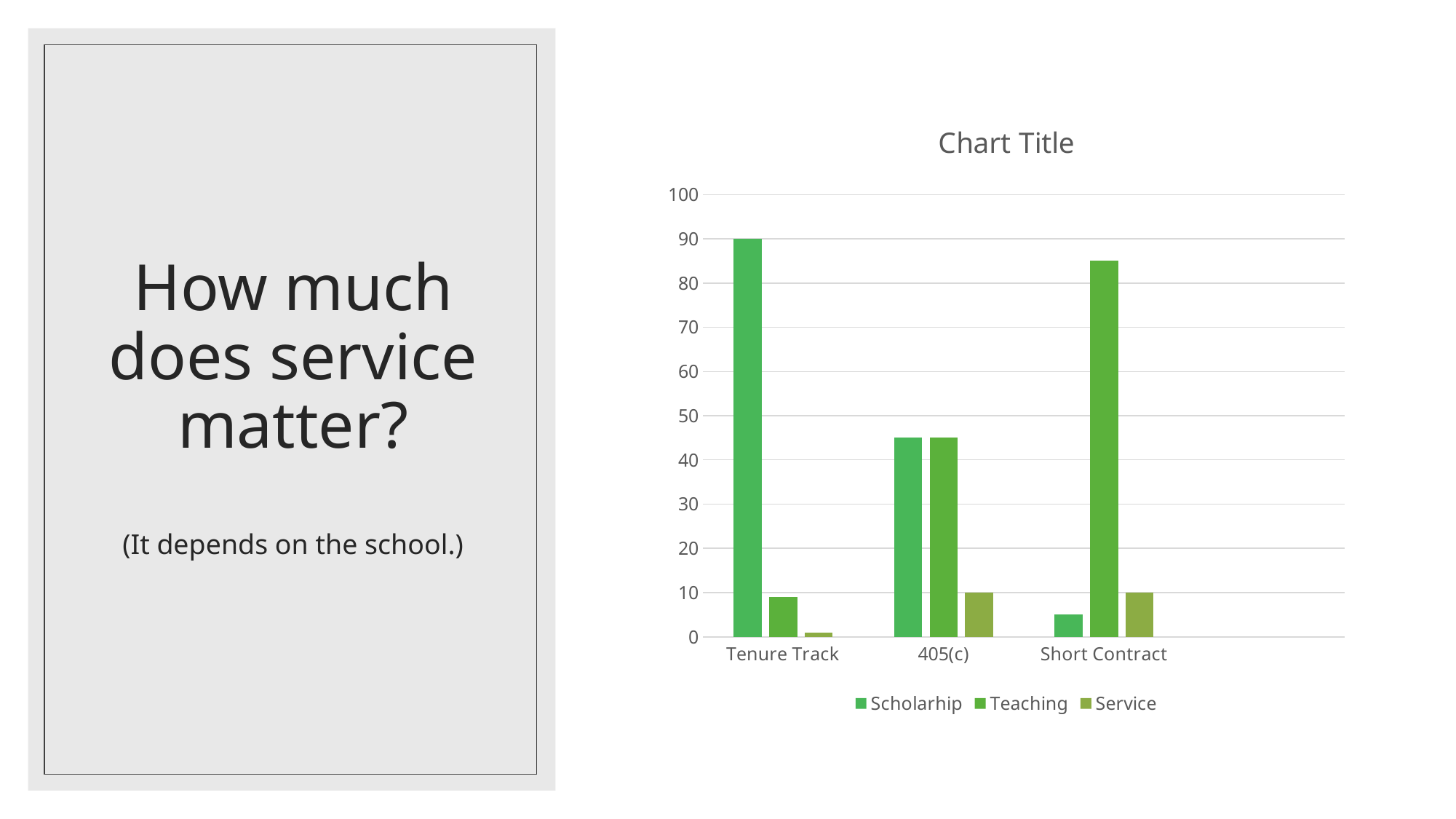
Which category has the highest Scholarship value? Tenure Track What is the Service value for Short Contract? 10 Which is larger, the Teaching value for Tenure Track or the Teaching value for 405(c)? 405(c) What is the Scholarship value for Tenure Track? 90 Is the Teaching value for Short Contract greater or less than 80? greater Is the Scholarship value for Short Contract greater or less than 10? less Which series has the highest value for Short Contract? Teaching How many categories are shown on the x axis? 3 What kind of chart is shown on the slide? bar chart What is the Service value for 405(c)? 10 Which series has the lowest value for Tenure Track? Service How many series does the legend list? 3